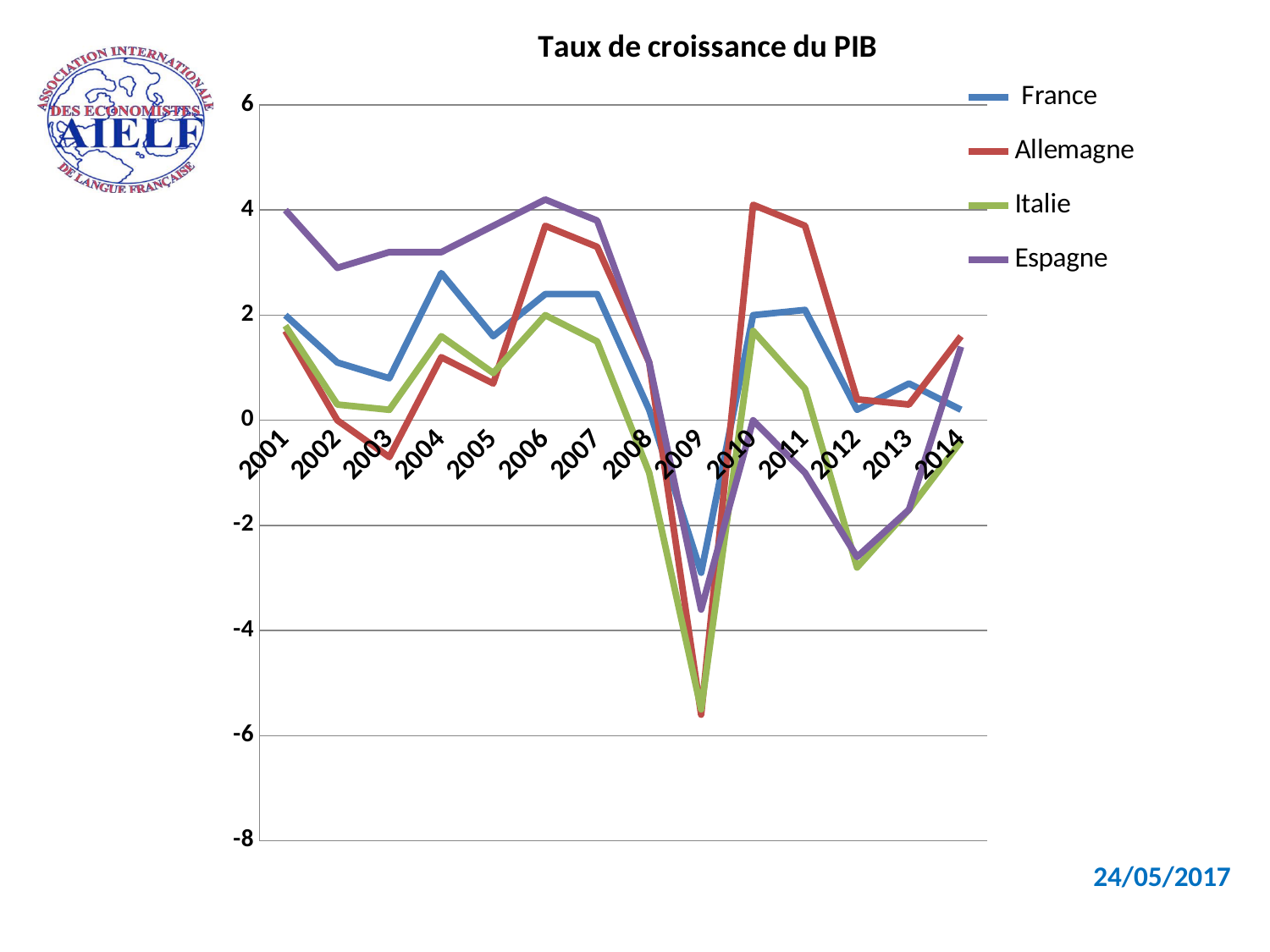
What kind of chart is shown on the slide? line chart How many years are plotted along the x axis? 14 Which series has the highest value in 2009? France Is the value for Allemagne in 2009 greater or less than -4? less Does the France series rise or fall from 2006 to 2009? fall In which year is the France series at its lowest? 2009 Is the value for France in 2004 greater or less than 2? greater Is the value for Italie in 2012 greater or less than -2? less How many series does the legend list? 4 Which series has the highest value in 2011? Allemagne Which series is drawn in red? Allemagne What is the title of the chart? Taux de croissance du PIB